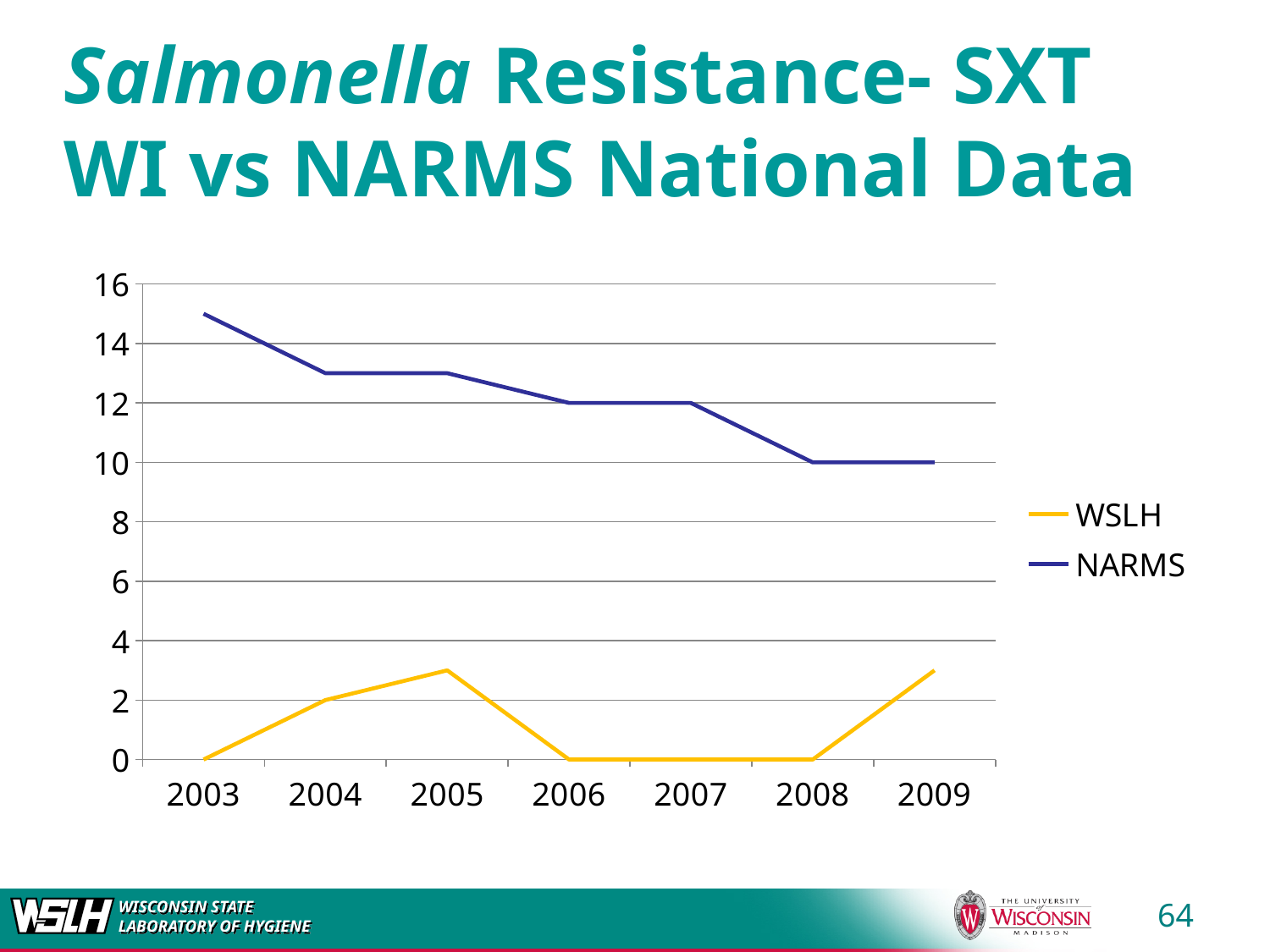
Does the NARMS line generally rise or fall from 2003 to 2009? fall How many series does the legend list? 2 What is the NARMS value for 2006? 12 What is the difference between the NARMS value in 2006 and the NARMS value in 2008? 2 What kind of chart is shown on the slide? line chart Is the NARMS value for 2003 greater or less than 14? greater What is the WSLH value for 2004? 2 How many years are shown on the x axis? 7 Is the WSLH value for 2005 greater or less than 4? less What is the WSLH value for 2007? 0 What is the NARMS value for 2008? 10 In 2005, which series has the higher value, WSLH or NARMS? NARMS